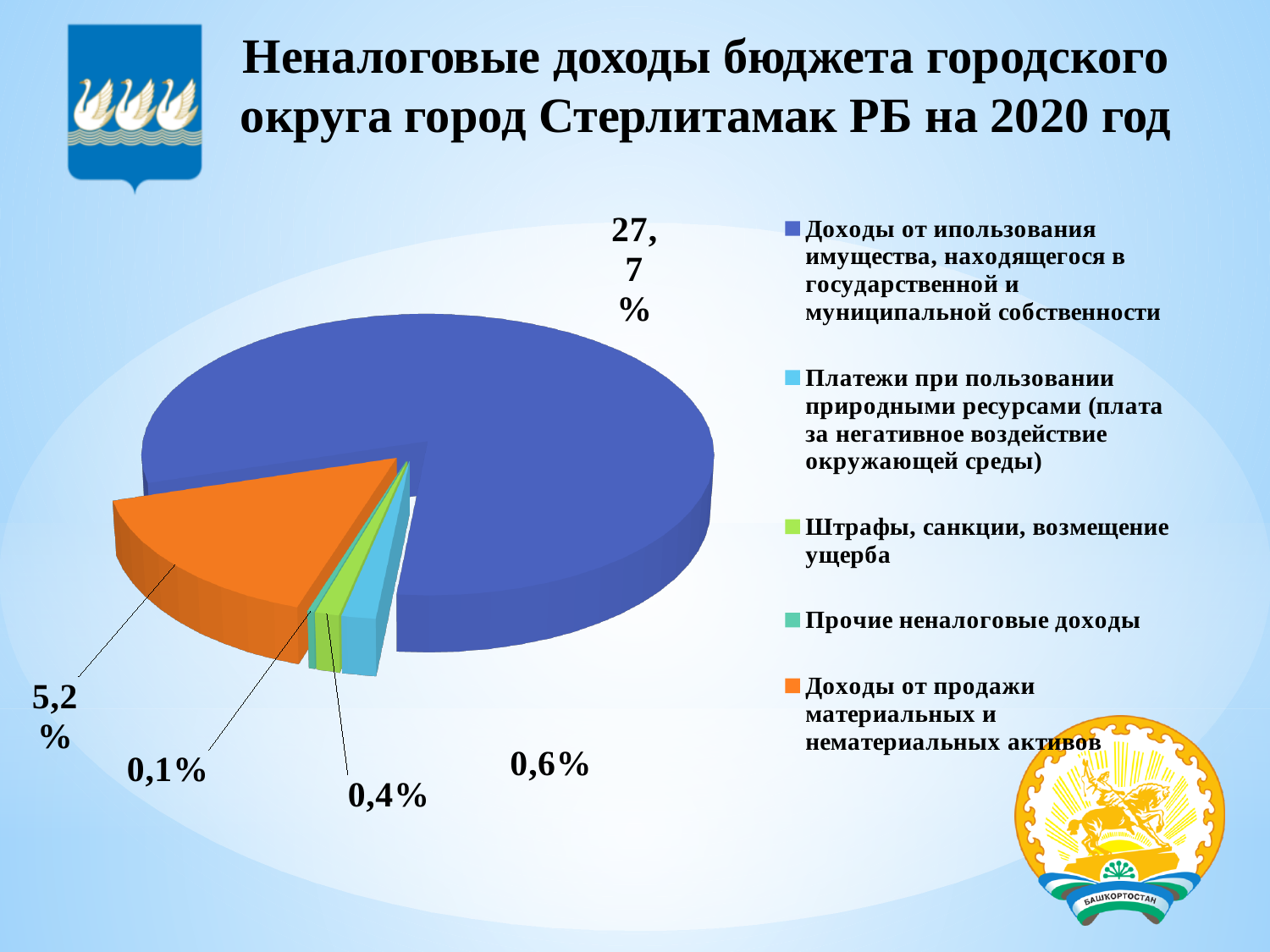
What colour represents Штрафы, санкции, возмещение ущерба in the legend? green What type of chart is shown on the slide? pie chart What is the value labelled on the largest slice of the pie chart? 27,7% What is the difference between the largest labelled value (27,7%) and the value for Доходы от продажи материальных и нематериальных активов (5,2%)? 22,5% Which is larger: the slice for Доходы от ипользования имущества or the slice for Доходы от продажи материальных и нематериальных активов? Доходы от ипользования имущества What is the difference between the largest labelled value (27,7%) and the smallest labelled value (0,1%)? 27,6% How many data labels are shown on the pie chart? 5 What is the smallest value labelled on the pie chart? 0,1% What is the title of the slide? Неналоговые доходы бюджета городского округа город Стерлитамак РБ на 2020 год How many categories does the legend list? 5 Which category has the largest slice in the pie chart? Доходы от ипользования имущества, находящегося в государственной и муниципальной собственности What is the value labelled on the orange slice (Доходы от продажи материальных и нематериальных активов)? 5,2%